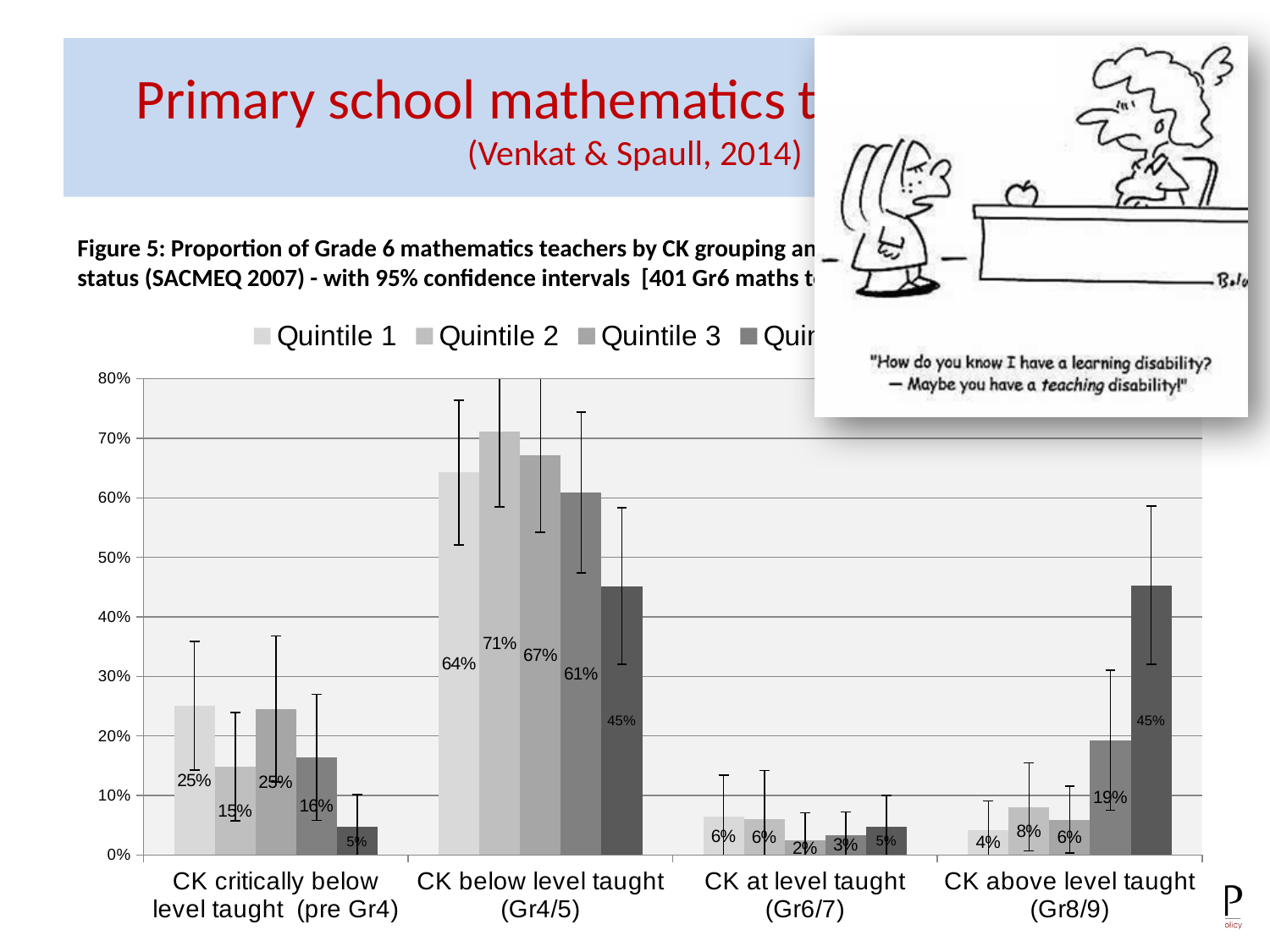
What kind of chart is shown on the slide? bar chart What is the difference between the Quintile 2 and Quintile 1 values in the 'CK below level taught (Gr4/5)' category? 7% In the 'CK critically below level taught (pre Gr4)' category, which is larger: Quintile 1 or Quintile 2? Quintile 1 According to the figure caption, what do the error bars on the chart represent? 95% confidence intervals What is the value for Quintile 2 in the 'CK below level taught (Gr4/5)' category? 71% What is the value for Quintile 3 in the 'CK above level taught (Gr8/9)' category? 6% In which category is the Quintile 2 value lowest? CK at level taught (Gr6/7) How many CK grouping categories are shown on the x axis? 4 Is the value for Quintile 3 in the 'CK below level taught (Gr4/5)' category greater or less than 60%? greater What is the value for Quintile 1 in the 'CK critically below level taught (pre Gr4)' category? 25% In which category is the Quintile 1 value highest? CK below level taught (Gr4/5) What is the value for Quintile 3 in the 'CK at level taught (Gr6/7)' category? 2%